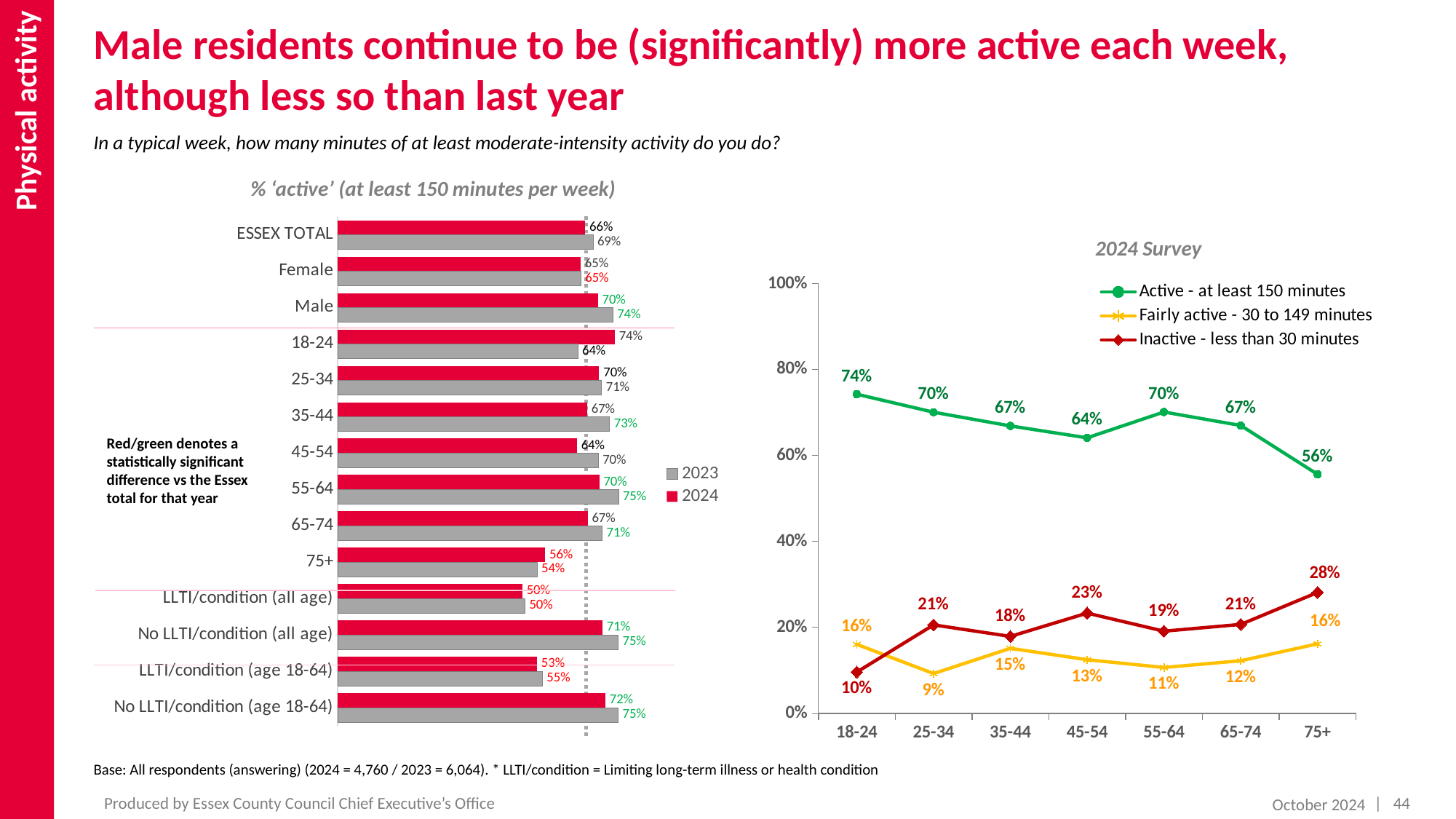
In the '2024 Survey' line chart, which age group has the lowest value for 'Fairly active - 30 to 149 minutes'? 25-34 In the '2024 Survey' line chart, how many series does the legend list? 3 In the '2024 Survey' line chart, which age group has the highest value for 'Inactive - less than 30 minutes'? 75+ In the '2024 Survey' line chart, what is the value for 'Active - at least 150 minutes' for the 18-24 age group? 74% In the '2024 Survey' line chart, does the 'Inactive - less than 30 minutes' series generally rise or fall from 18-24 to 75+? rise In the '% active (at least 150 minutes per week)' bar chart, what is the 2024 value for Male? 70% In the '% active (at least 150 minutes per week)' bar chart, which is larger: the 2024 value for 18-24 or the 2024 value for 75+? 18-24 In the '2024 Survey' line chart, what is the difference between the 'Active' value for 18-24 and the 'Active' value for 75+? 18% In the '% active (at least 150 minutes per week)' bar chart, what is the difference between the 2023 and 2024 values for ESSEX TOTAL? 3% In the '2024 Survey' line chart, what is the value for 'Inactive - less than 30 minutes' for the 75+ age group? 28% In the '% active (at least 150 minutes per week)' bar chart, what is the 2023 value for 18-24? 64% What type of chart is the '% active (at least 150 minutes per week)' chart on the left? bar chart